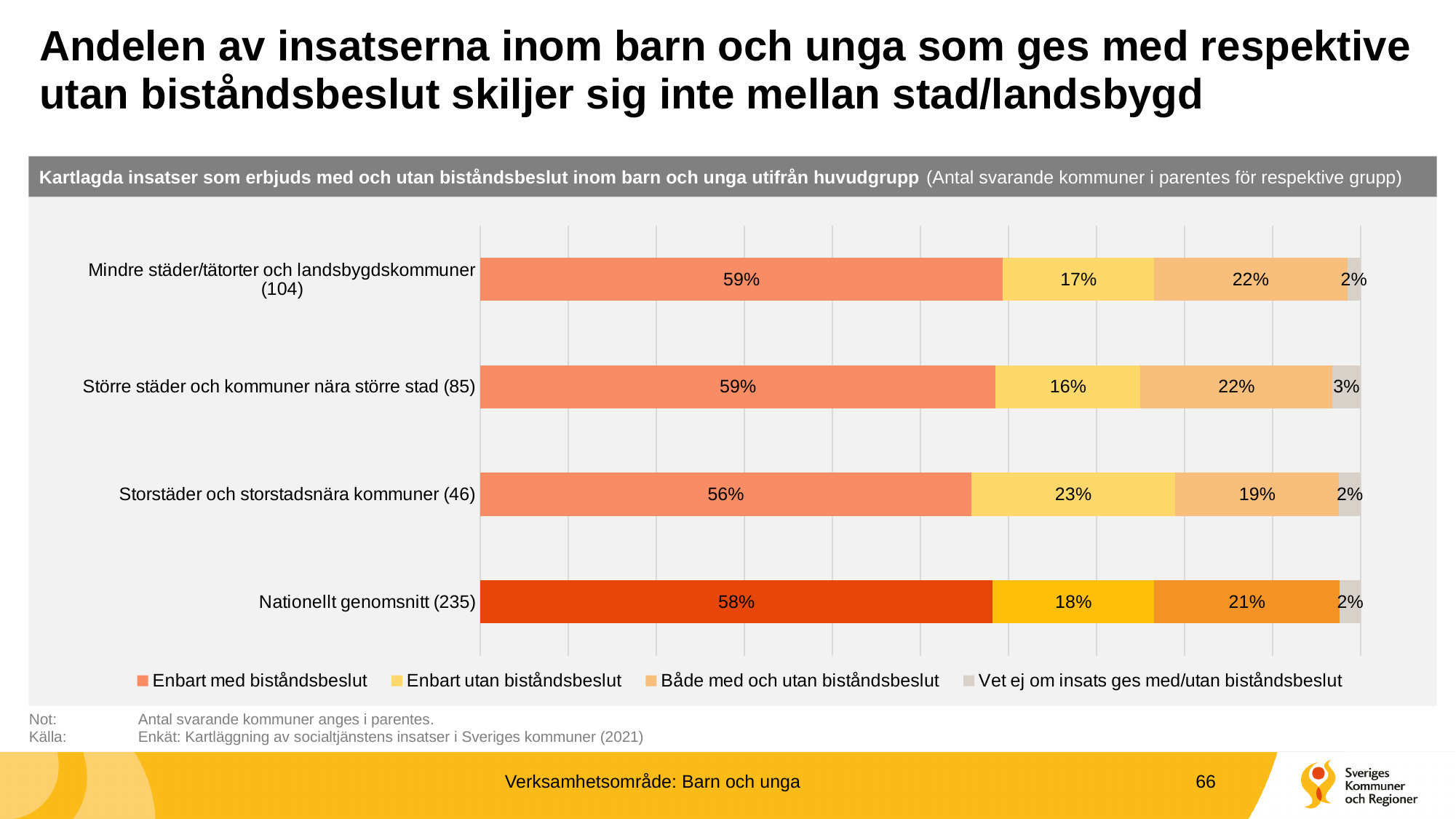
What is the value for 'Både med och utan biståndsbeslut' for Nationellt genomsnitt (235)? 21% What is the value for 'Vet ej om insats ges med/utan biståndsbeslut' for Större städer och kommuner nära större stad (85)? 3% What is the value for 'Enbart utan biståndsbeslut' for Storstäder och storstadsnära kommuner (46)? 23% What is the total of the stacked bar for Mindre städer/tätorter och landsbygdskommuner (104)? 100% Which category has the highest value for 'Enbart utan biståndsbeslut'? Storstäder och storstadsnära kommuner (46) How many categories (groups of municipalities) are shown on the chart? 4 How many series does the legend list? 4 Which has a larger value for 'Både med och utan biståndsbeslut': Mindre städer/tätorter och landsbygdskommuner (104) or Storstäder och storstadsnära kommuner (46)? Mindre städer/tätorter och landsbygdskommuner (104) What kind of chart is shown on the slide? Stacked bar chart What is the difference in 'Enbart utan biståndsbeslut' between Storstäder och storstadsnära kommuner (46) and Större städer och kommuner nära större stad (85)? 7 percentage points Which category has the lowest value for 'Enbart med biståndsbeslut'? Storstäder och storstadsnära kommuner (46) Which category's bar is drawn in darker colours than the others? Nationellt genomsnitt (235)